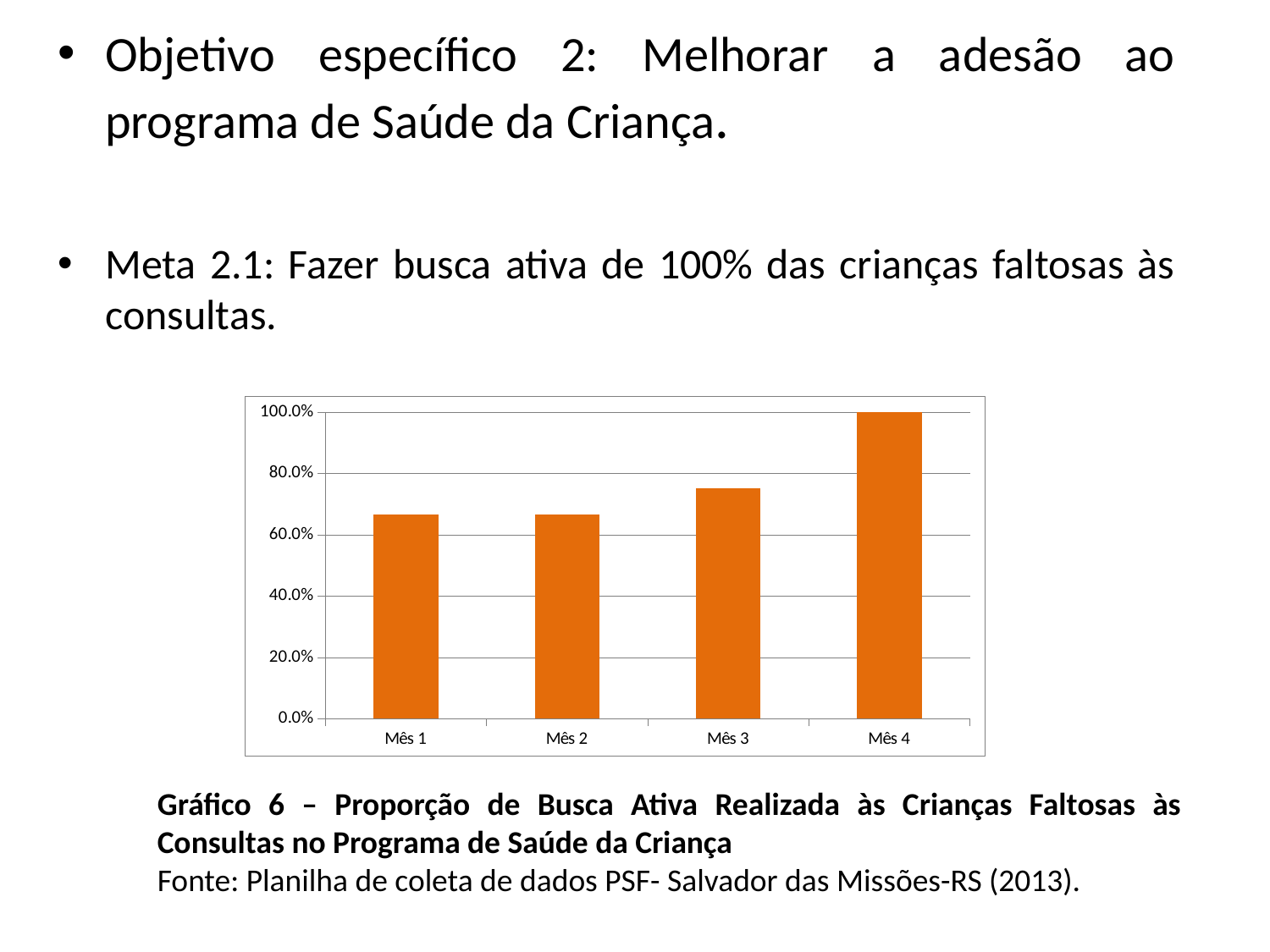
Is the value for Mês 3 greater or less than 60.0%? greater What is the value for Mês 4 in the chart? 100.0% What kind of chart is shown on the slide? bar chart Which month has the highest value in the chart? Mês 4 Do the values generally rise or fall from Mês 1 to Mês 4? rise Which is larger, the value for Mês 3 or the value for Mês 1? Mês 3 Is the value for Mês 1 greater or less than 80.0%? less How many months (categories) are shown on the x axis of the chart? 4 Is the value for Mês 3 greater or less than 80.0%? less What is the number of the graph given in the caption below the chart? Gráfico 6 Which is larger, the value for Mês 4 or the value for Mês 2? Mês 4